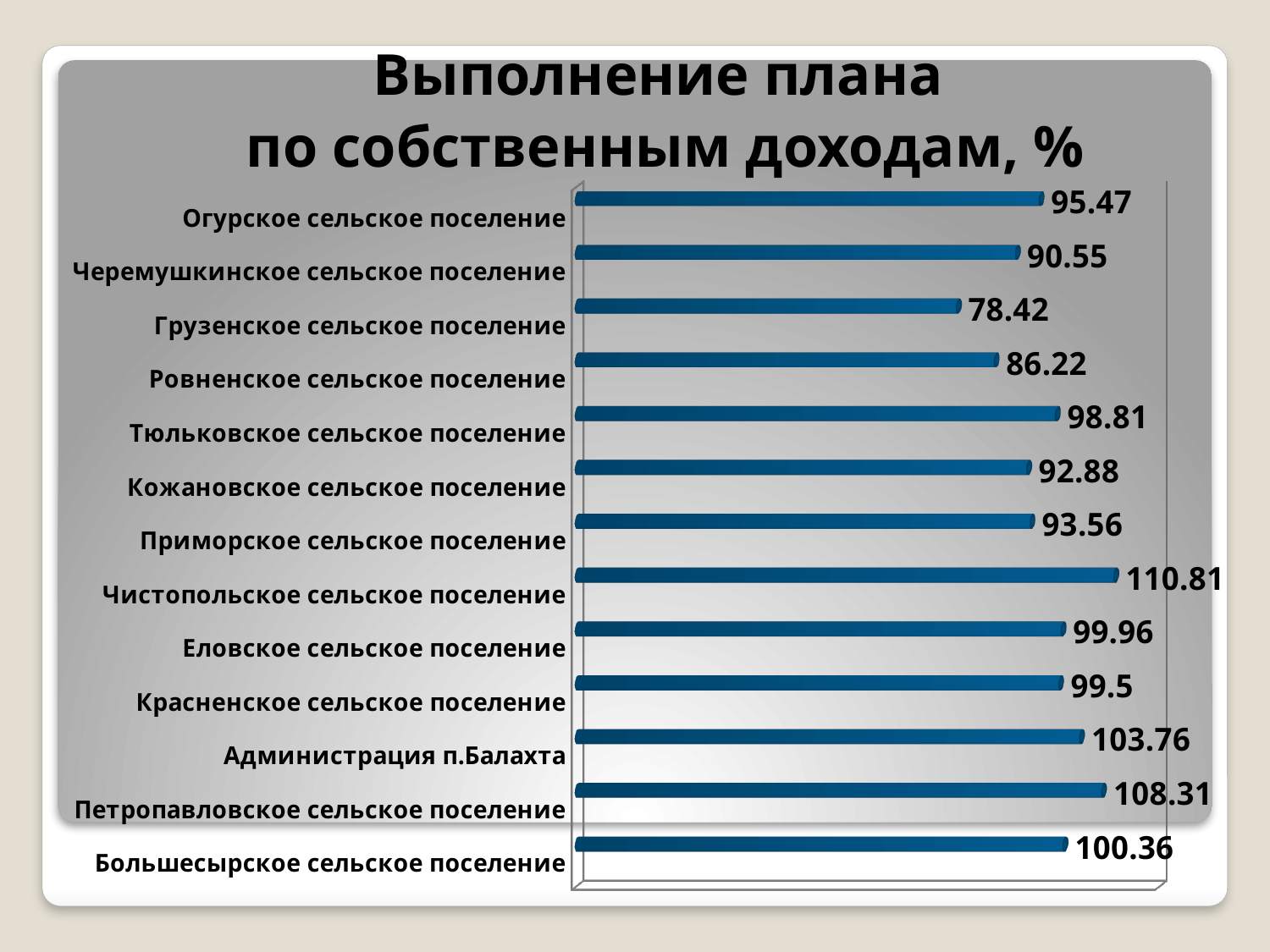
Which category has the highest value? Чистопольское сельское поселение How many categories are shown in the chart? 13 What is the value for Огурское сельское поселение? 95.47 What is the value for Ровненское сельское поселение? 86.22 What is the title of the chart? Выполнение плана по собственным доходам, % Which is larger, the value for Тюльковское сельское поселение or the value for Кожановское сельское поселение? Тюльковское сельское поселение Which category has the lowest value? Грузенское сельское поселение What is the value for Администрация п.Балахта? 103.76 What kind of chart is shown on the slide? Bar chart What is the value for Большесырское сельское поселение? 100.36 What is the difference between the values for Петропавловское сельское поселение and Большесырское сельское поселение? 7.95 What is the difference between the values for Чистопольское сельское поселение and Грузенское сельское поселение? 32.39